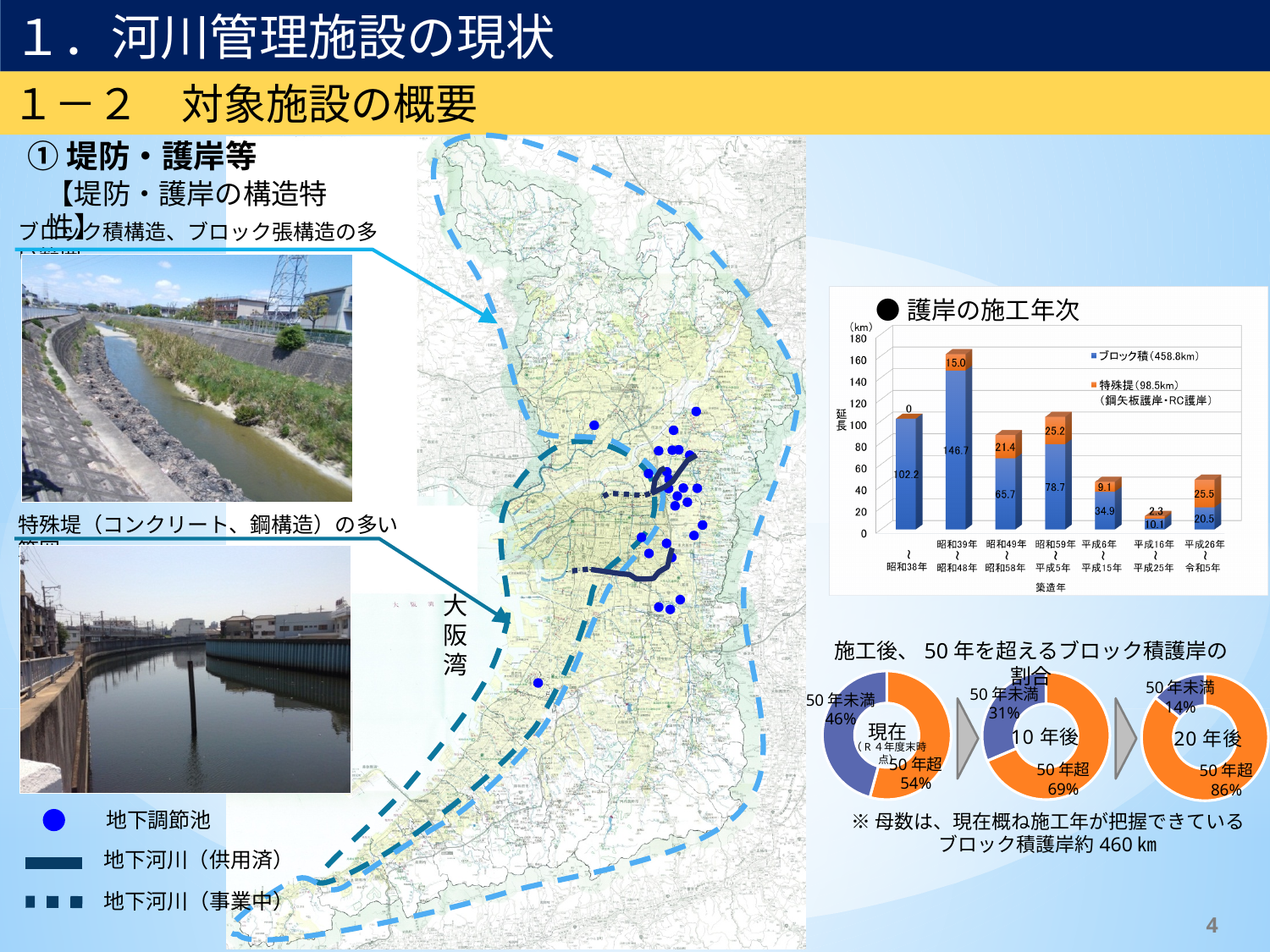
In the bar chart titled 護岸の施工年次, which is larger: the 特殊提 value for 平成26年～令和5年 or the ブロック積 value for 平成26年～令和5年? 特殊提 In the bar chart titled 護岸の施工年次, what is the value of 特殊提 for 昭和59年～平成5年? 25.2 In the bar chart titled 護岸の施工年次, which 築造年 category has the lowest ブロック積 value? 平成16年～平成25年 What kind of chart is 護岸の施工年次? Stacked bar chart In the bar chart titled 護岸の施工年次, what is the difference between the ブロック積 values for ～昭和38年 and 昭和49年～昭和58年? 36.5 How many 築造年 categories are shown in the bar chart titled 護岸の施工年次? 7 In the donut chart labelled 20年後, what share is 50年未満? 14% In the bar chart titled 護岸の施工年次, what is the total of the stacked bar for 昭和49年～昭和58年? 87.1 In the bar chart titled 護岸の施工年次, which 築造年 category has the highest ブロック積 value? 昭和39年～昭和48年 How many series does the legend of the bar chart titled 護岸の施工年次 list? 2 In the donut chart labelled 10年後, what share is 50年超? 69% In the bar chart titled 護岸の施工年次, what is the value of ブロック積 for 昭和39年～昭和48年? 146.7